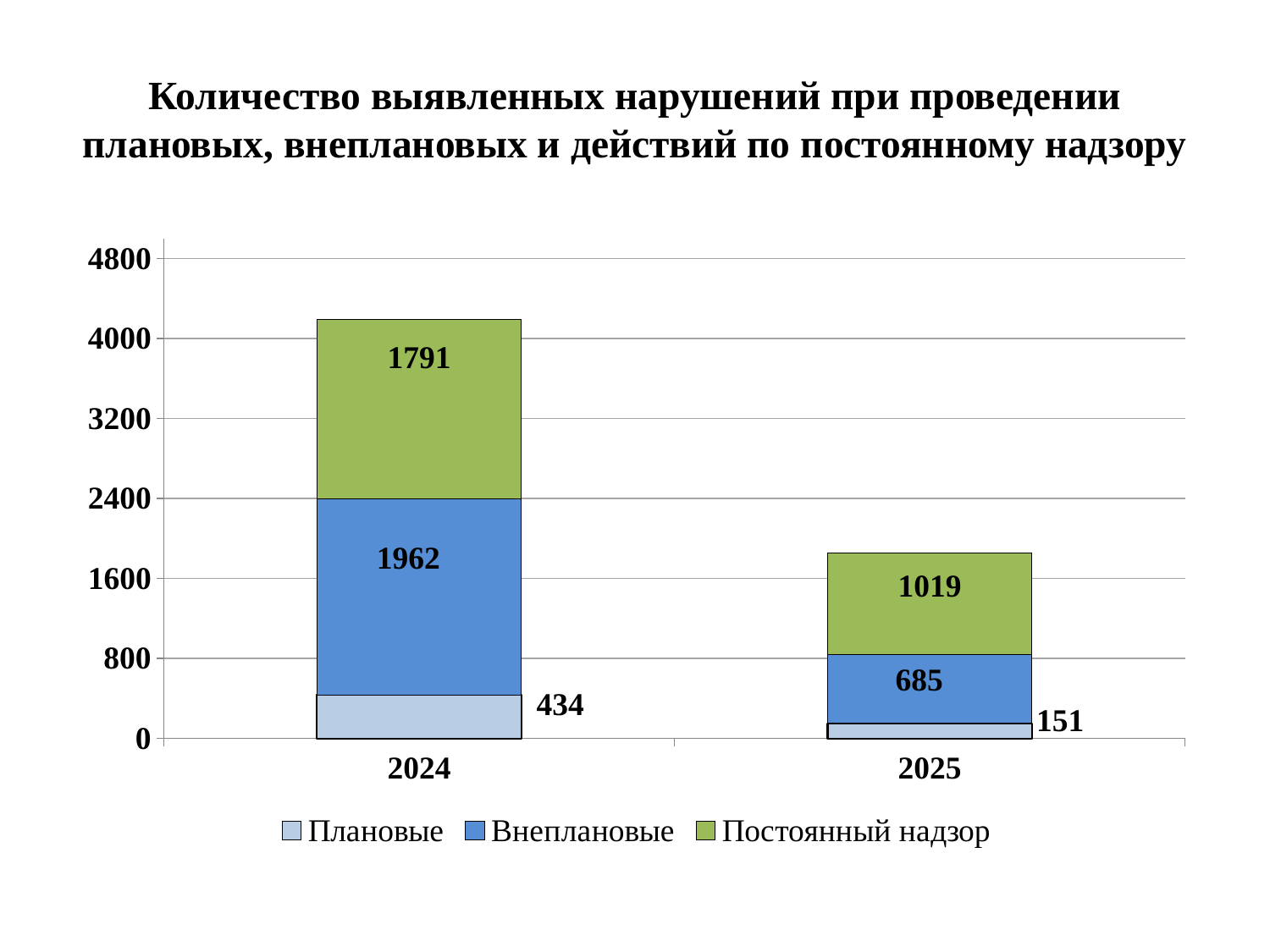
What is the total of the stacked bar for 2024? 4187 How many categories (years) are shown on the x axis? 2 What type of chart is shown on the slide? Stacked bar chart What is the total of the stacked bar for 2025? 1855 How many series does the legend list? 3 What is the difference between the Плановые values for 2024 and 2025? 283 Which is larger in 2024: Внеплановые or Постоянный надзор? Внеплановые Which year has the higher total number of violations? 2024 What is the value for Плановые in 2025? 151 What is the value for Постоянный надзор in 2025? 1019 Which series is shown in green in the legend? Постоянный надзор What is the value for Внеплановые in 2024? 1962